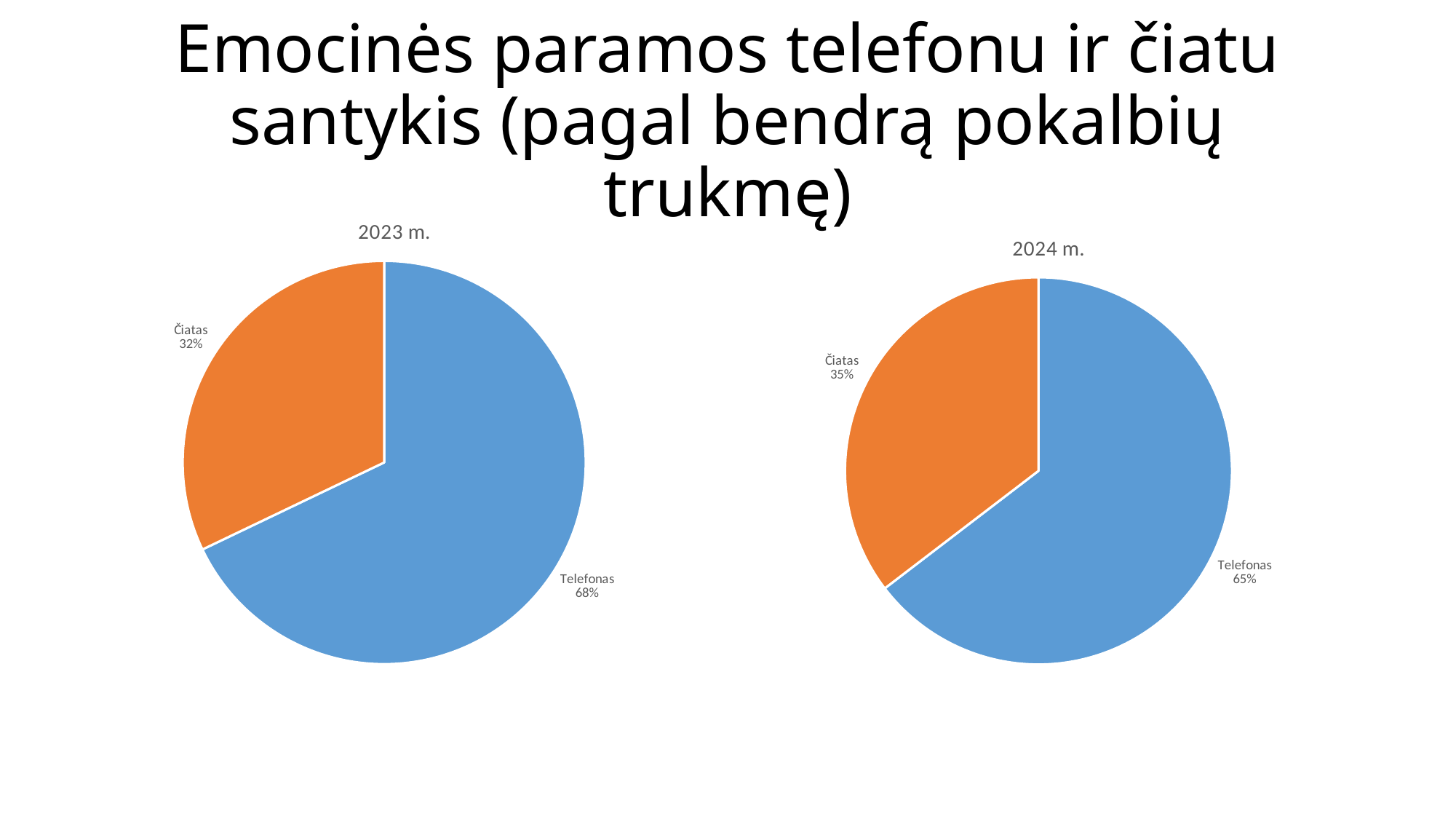
What type of chart is the "2023 m." chart? Pie chart In the "2024 m." pie chart, what share does Telefonas have? 65% In the "2023 m." pie chart, what share does Telefonas have? 68% In the "2023 m." pie chart, what share does Čiatas have? 32% In the "2023 m." pie chart, what is the difference in percentage points between Telefonas and Čiatas? 36 In the "2023 m." pie chart, what colour is the Telefonas slice? Blue In the "2024 m." pie chart, which slice is the smallest? Čiatas Is the Čiatas share larger in the "2023 m." chart or the "2024 m." chart? 2024 m. How many slices does the "2024 m." pie chart have? 2 In the "2023 m." pie chart, which slice is the largest? Telefonas In the "2024 m." pie chart, what is the difference in percentage points between Telefonas and Čiatas? 30